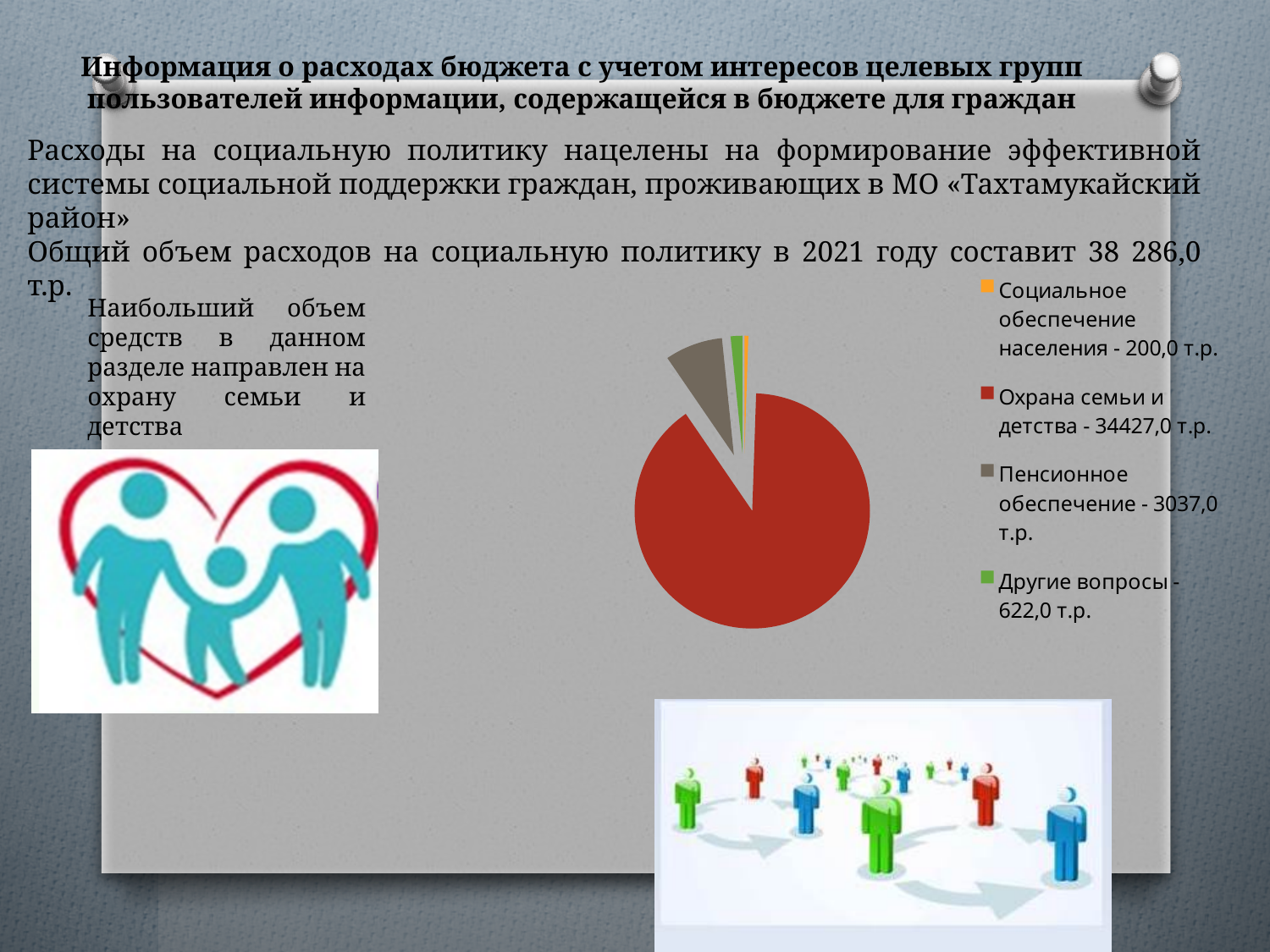
Which colour represents Охрана семьи и детства in the pie chart? red How many categories does the pie chart show? 4 Which category has the largest slice in the pie chart? Охрана семьи и детства What is the value for Социальное обеспечение населения in the pie chart? 200,0 т.р. Which is larger in the pie chart: Пенсионное обеспечение or Другие вопросы? Пенсионное обеспечение Which category has the smallest slice in the pie chart? Социальное обеспечение населения What is the value for Пенсионное обеспечение in the pie chart? 3037,0 т.р. What is the difference between Охрана семьи и детства and Пенсионное обеспечение in the pie chart? 31390,0 т.р. What is the difference between Другие вопросы and Социальное обеспечение населения in the pie chart? 422,0 т.р. What kind of chart is shown on the slide? pie chart What is the value for Другие вопросы in the pie chart? 622,0 т.р. What is the value for Охрана семьи и детства in the pie chart? 34427,0 т.р.